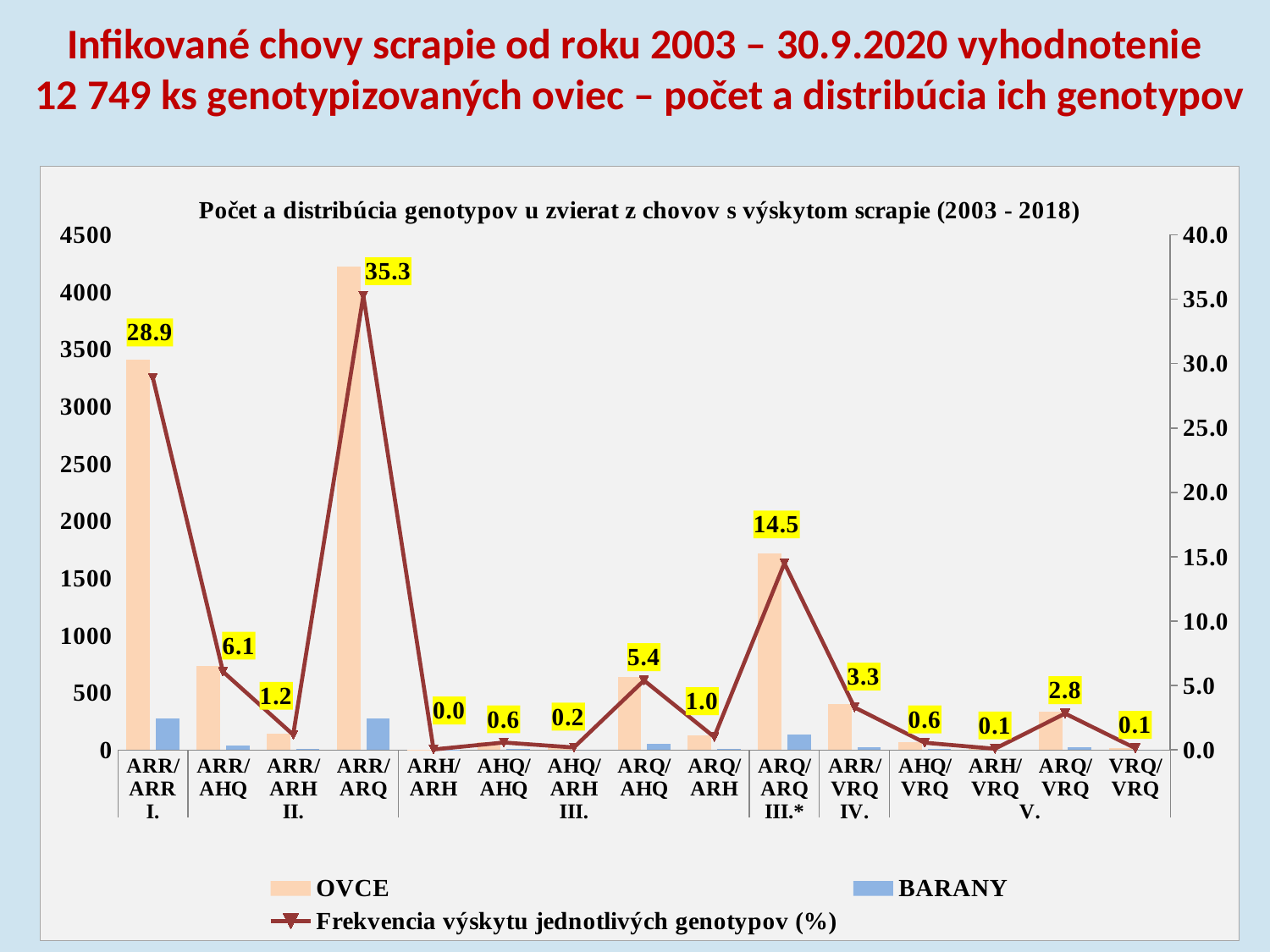
Is the OVCE bar for ARR/ARQ greater or less than 4000? greater How many genotype categories are shown on the x axis? 15 Which genotype has a higher frequency of occurrence: ARQ/ARQ or ARR/AHQ? ARQ/ARQ What is the frequency of occurrence (%) shown for the ARR/ARR genotype? 28.9 Which genotype has the highest frequency of occurrence (%)? ARR/ARQ What kind of chart is shown on the slide? Combination bar and line chart Which genotype has the lowest frequency of occurrence (%)? ARH/ARH How many series does the legend list? 3 What is the difference between the frequency of occurrence for ARR/ARQ and ARR/ARR? 6.4 Is the OVCE bar for ARQ/ARQ greater or less than 1500? greater What is the frequency of occurrence (%) shown for the ARR/ARQ genotype? 35.3 What is the frequency of occurrence (%) shown for the ARQ/AHQ genotype? 5.4